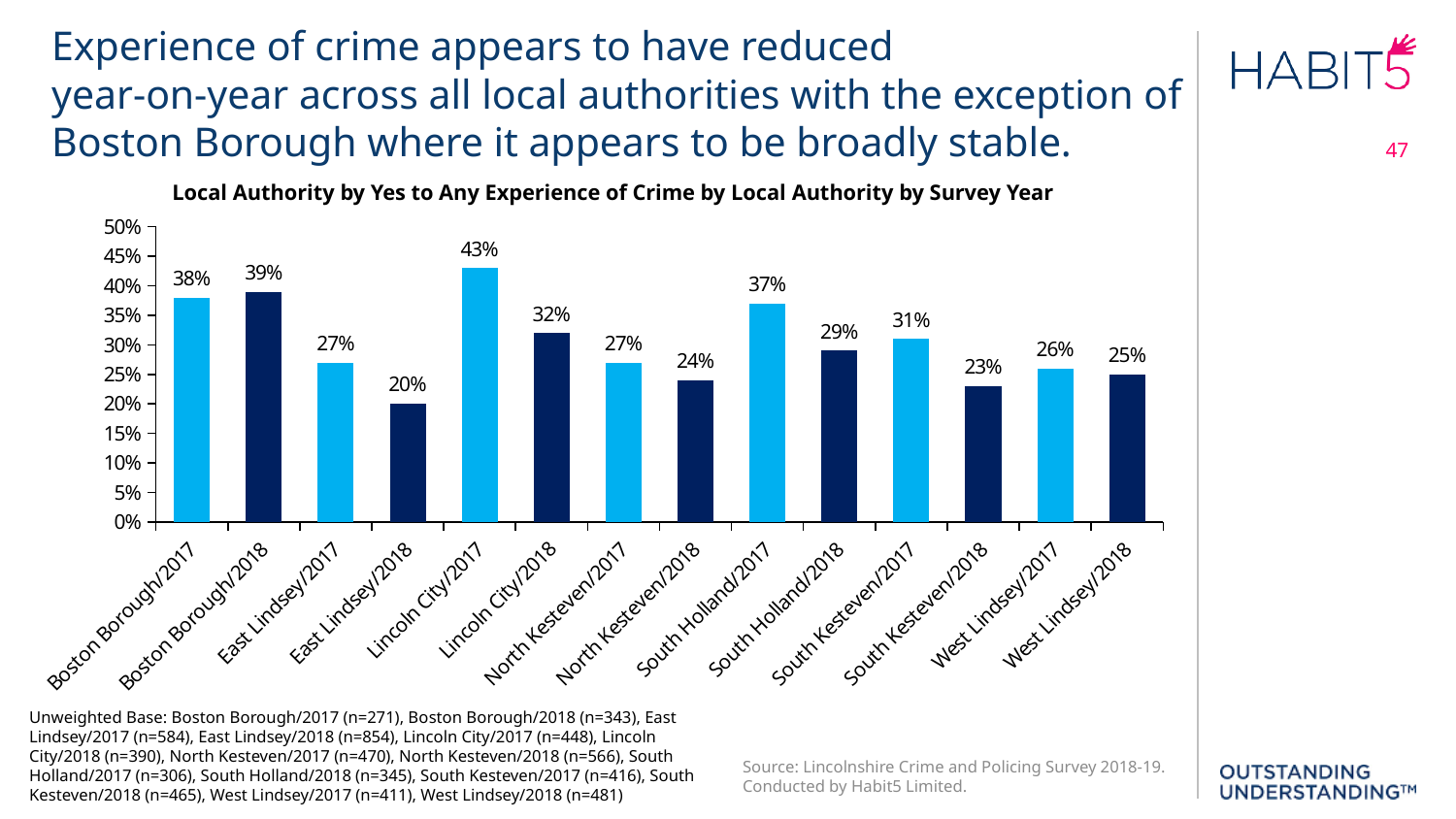
What is the value for Lincoln City/2017? 43% What is the value for South Holland/2017? 37% What is the value for East Lindsey/2018? 20% What is the title of the chart? Local Authority by Yes to Any Experience of Crime by Local Authority by Survey Year Is the value for North Kesteven/2018 greater or less than 30%? less What is the difference between Lincoln City/2017 and Lincoln City/2018? 11% What is the difference between Boston Borough/2018 and Boston Borough/2017? 1% Which is larger, South Holland/2017 or South Kesteven/2017? South Holland/2017 Which category has the lowest value? East Lindsey/2018 What kind of chart is shown on the slide? bar chart Which category has the highest value? Lincoln City/2017 How many bars are shown in the chart? 14